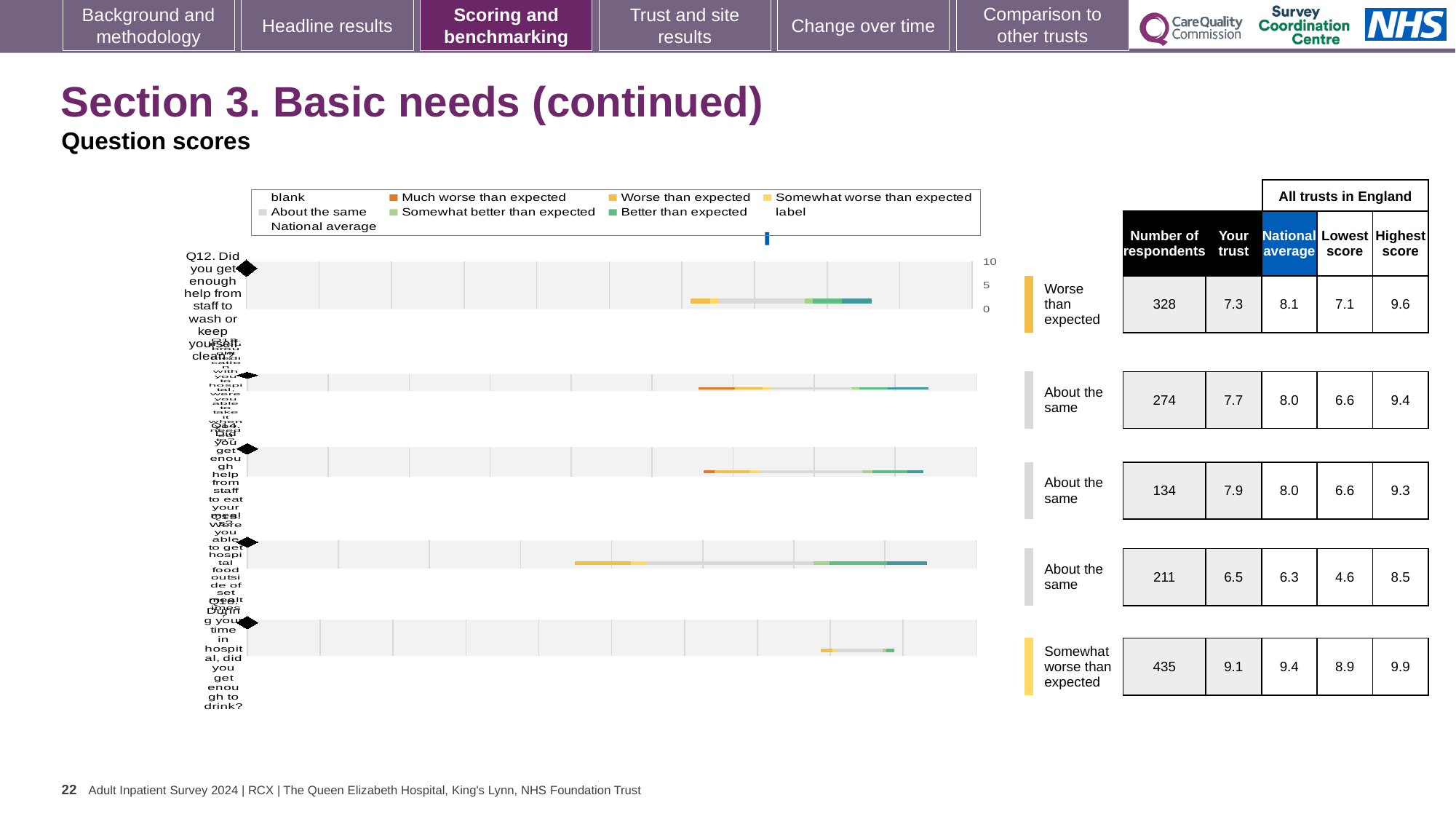
Which question has the highest 'Your trust' score? Q16 (did you get enough to drink), 9.1 What is the 'Your trust' score for Q12 (help from staff to wash or keep yourself clean)? 7.3 What is the maximum value shown on the chart's score axis? 10 Which question has the lowest 'Your trust' score? Q15 (hospital food outside of set meal times), 6.5 How many respondents answered Q16 (did you get enough to drink)? 435 For Q12, how much higher is the national average than the 'Your trust' score? 0.8 For Q15 (hospital food outside of set meal times), is the 'Your trust' score or the national average higher? Your trust (6.5) What colour does the legend use for 'Much worse than expected'? orange What benchmark category is given for Q12 (help from staff to wash or keep yourself clean)? Worse than expected How many questions (rows) are plotted in the chart? 5 What kind of chart is shown on the slide? bar chart What is the national average score for Q12 (help from staff to wash or keep yourself clean)? 8.1